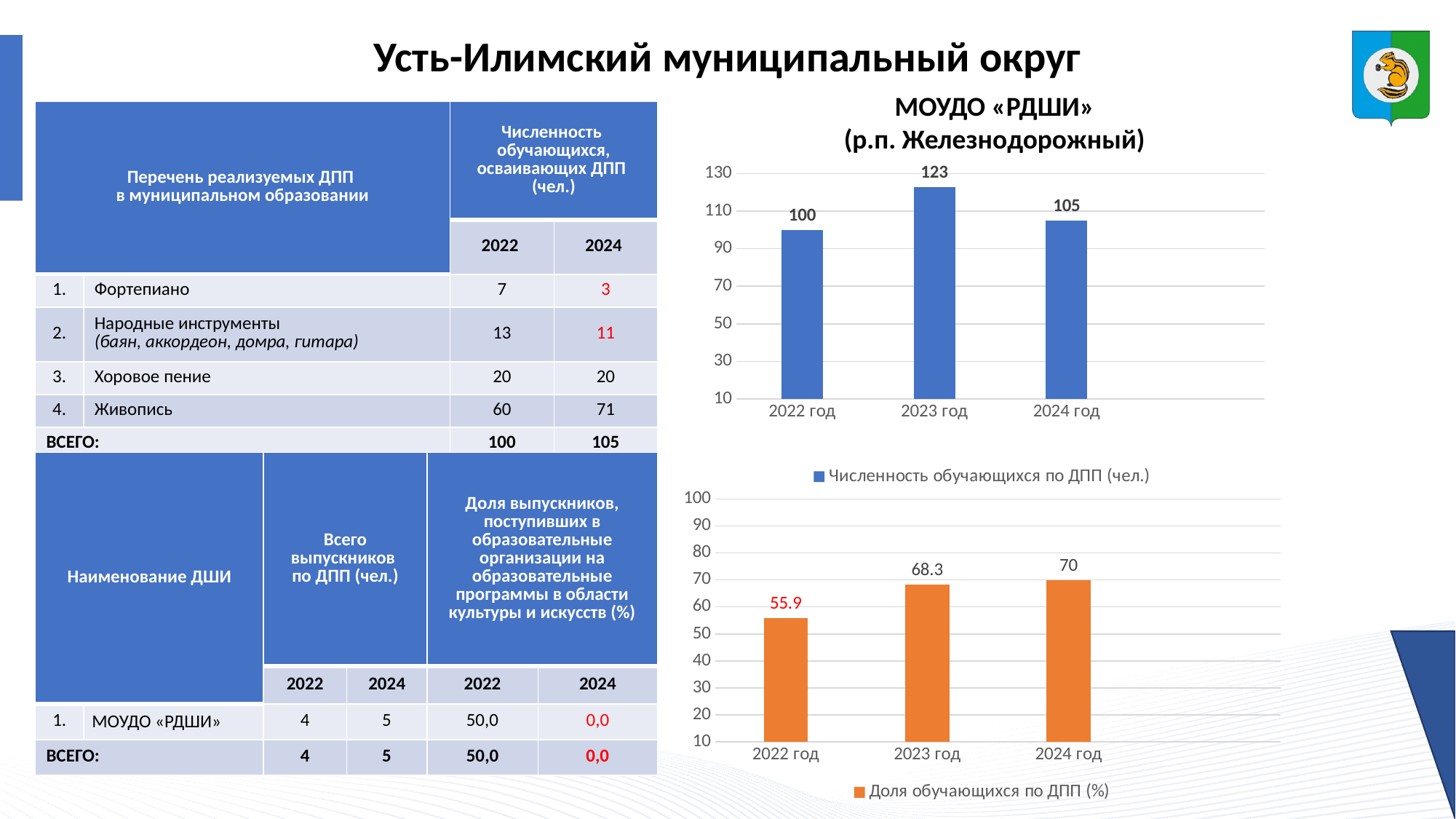
In the top chart (Численность обучающихся по ДПП), what is the value for 2023 год? 123 In the top chart (Численность обучающихся по ДПП), which year has the highest value? 2023 год In the top chart (Численность обучающихся по ДПП), what is the difference between the values for 2023 год and 2024 год? 18 What is the legend entry of the bottom chart? Доля обучающихся по ДПП (%) In the top chart (Численность обучающихся по ДПП), which year has the lowest value? 2022 год In the bottom chart (Доля обучающихся по ДПП), which is larger: the value for 2022 год or 2023 год? 2023 год In the top chart (Численность обучающихся по ДПП), what is the value for 2022 год? 100 In the bottom chart (Доля обучающихся по ДПП), what is the value for 2024 год? 70 What type of chart is the bottom chart (Доля обучающихся по ДПП)? bar chart In the bottom chart (Доля обучающихся по ДПП), what is the value for 2022 год? 55.9 In the top chart (Численность обучающихся по ДПП), how many bars are plotted? 3 In the bottom chart (Доля обучающихся по ДПП), do the values rise or fall from 2022 год to 2024 год? rise